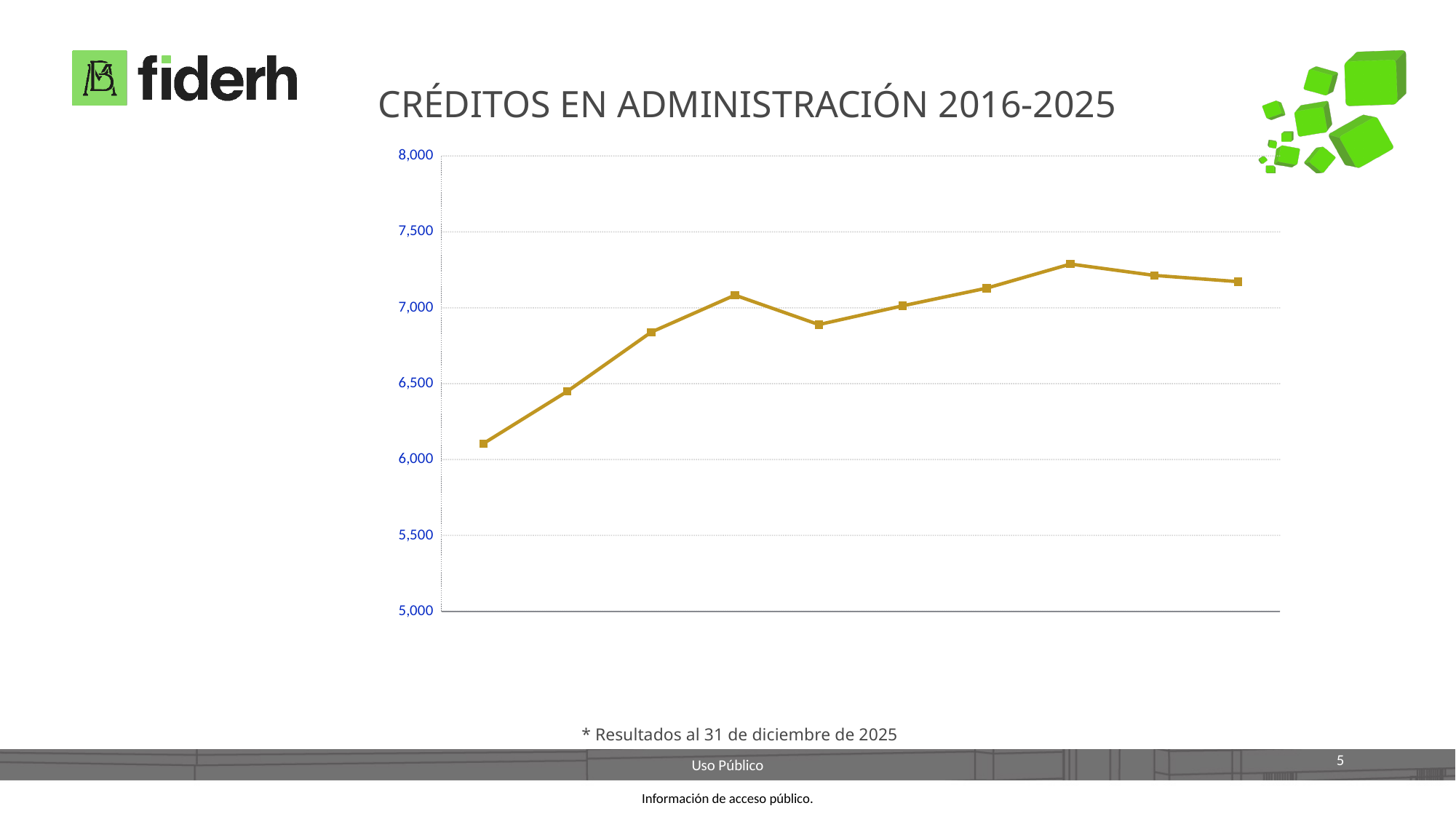
What is the title of the chart? CRÉDITOS EN ADMINISTRACIÓN 2016-2025 What are the lowest and highest values shown on the y axis? 5,000 and 8,000 Is the value of the first point on the line greater or less than 6,500? less Which is larger, the value of the first point or the value of the last point? the last point Which point on the line has the lowest value? the first point What kind of chart is shown on the slide? line chart How many data points are plotted on the line? 10 Is the highest point on the line greater or less than 7,500? less Which point on the line has the highest value? the eighth point Overall, do the values rise or fall from the first point to the last point along the x axis? rise Is the value of the third point on the line greater or less than 6,500? greater